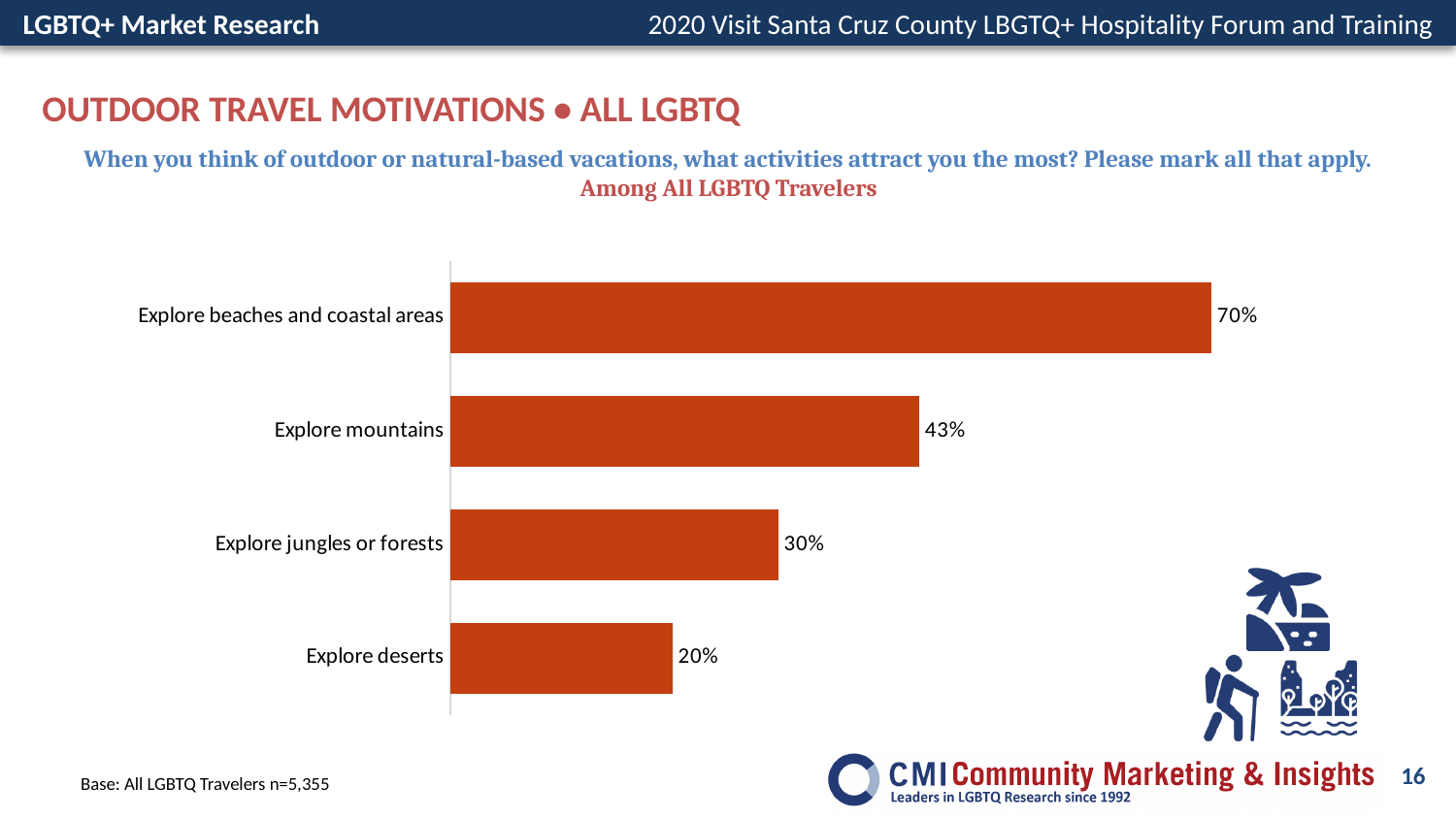
What percentage of LGBTQ travelers selected 'Explore beaches and coastal areas'? 70% Which has a larger value, 'Explore mountains' or 'Explore jungles or forests'? Explore mountains Which activity has the highest percentage? Explore beaches and coastal areas Which activity has the lowest percentage? Explore deserts What percentage is shown for 'Explore jungles or forests'? 30% What is the value for 'Explore deserts'? 20% How many activity categories are shown in the chart? 4 What is the difference in percentage points between 'Explore beaches and coastal areas' and 'Explore mountains'? 27 What is the base sample size stated for the chart? n=5,355 What type of chart is shown on the slide? Bar chart What is the difference in percentage points between 'Explore jungles or forests' and 'Explore deserts'? 10 What is the value shown for 'Explore mountains'? 43%